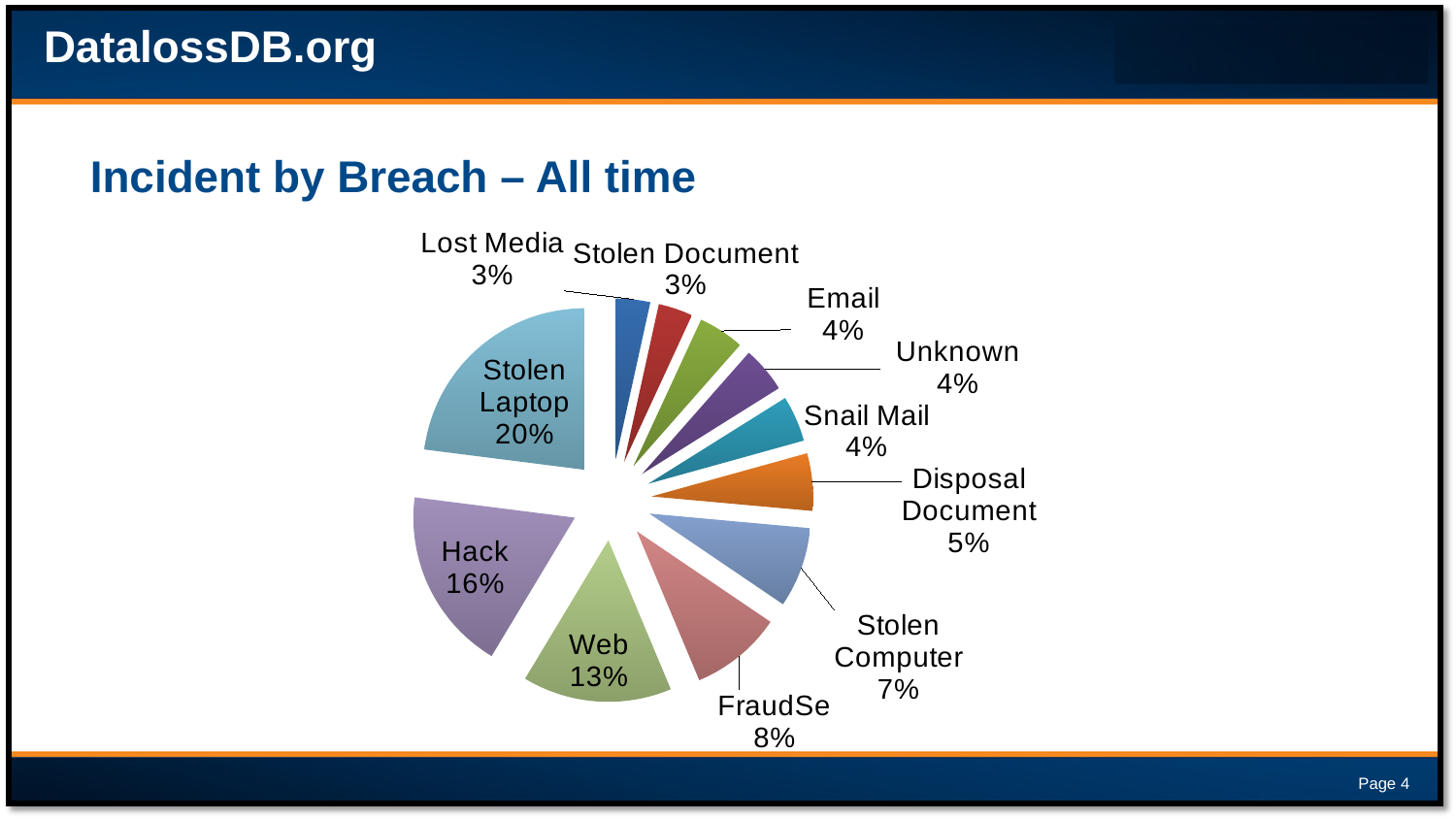
What share of incidents is attributed to Stolen Laptop? 20% What percentage is shown for Stolen Computer? 7% What is the difference in percentage points between Stolen Computer and Lost Media? 4 Which is larger, the share for Web or the share for FraudSe? Web What percentage is shown for Hack? 16% Which breach category has the largest share of the pie? Stolen Laptop What is the title of the chart? Incident by Breach – All time How many slices does the pie chart have? 11 What kind of chart is shown on the slide? Pie chart What percentage is shown for Disposal Document? 5% What is the difference in percentage points between Stolen Laptop and Hack? 4 What percentage is shown for Web? 13%